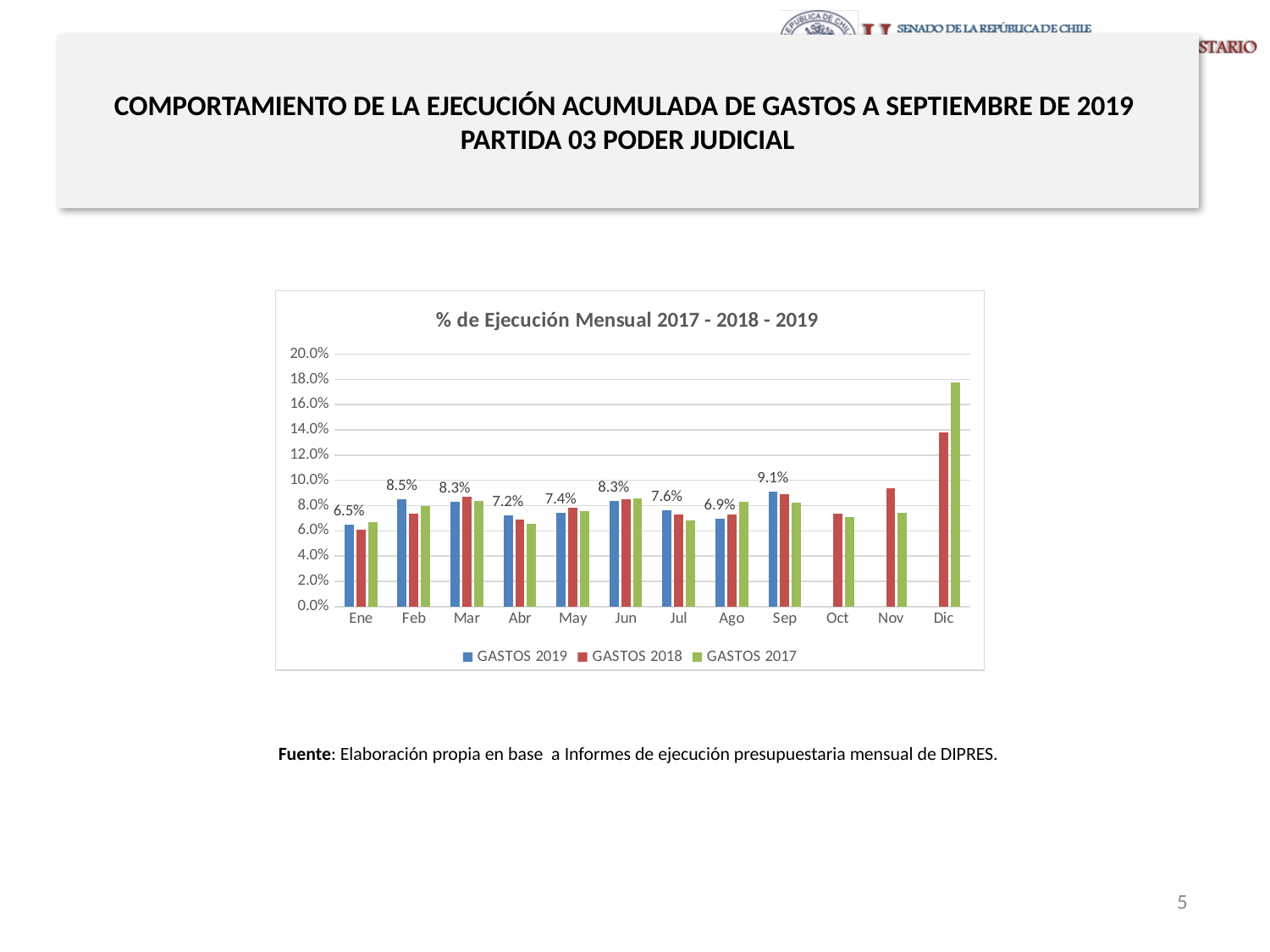
Is the value for GASTOS 2017 in Dic greater or less than 16.0%? greater Which month has the lowest value for GASTOS 2019? Ene What is the value of GASTOS 2019 for Abr? 7.2% What is the value of GASTOS 2019 for Sep? 9.1% Which month has the highest value for GASTOS 2019? Sep What type of chart is shown on the slide? Bar chart Is the value for GASTOS 2018 in Dic greater or less than 12.0%? greater For GASTOS 2019, which month has the larger value, Feb or Mar? Feb How many series does the chart legend list? 3 How many months are shown on the x axis of the chart? 12 What is the value of GASTOS 2019 for Ene? 6.5% What is the difference between the GASTOS 2019 values for Sep and Ene? 2.6%